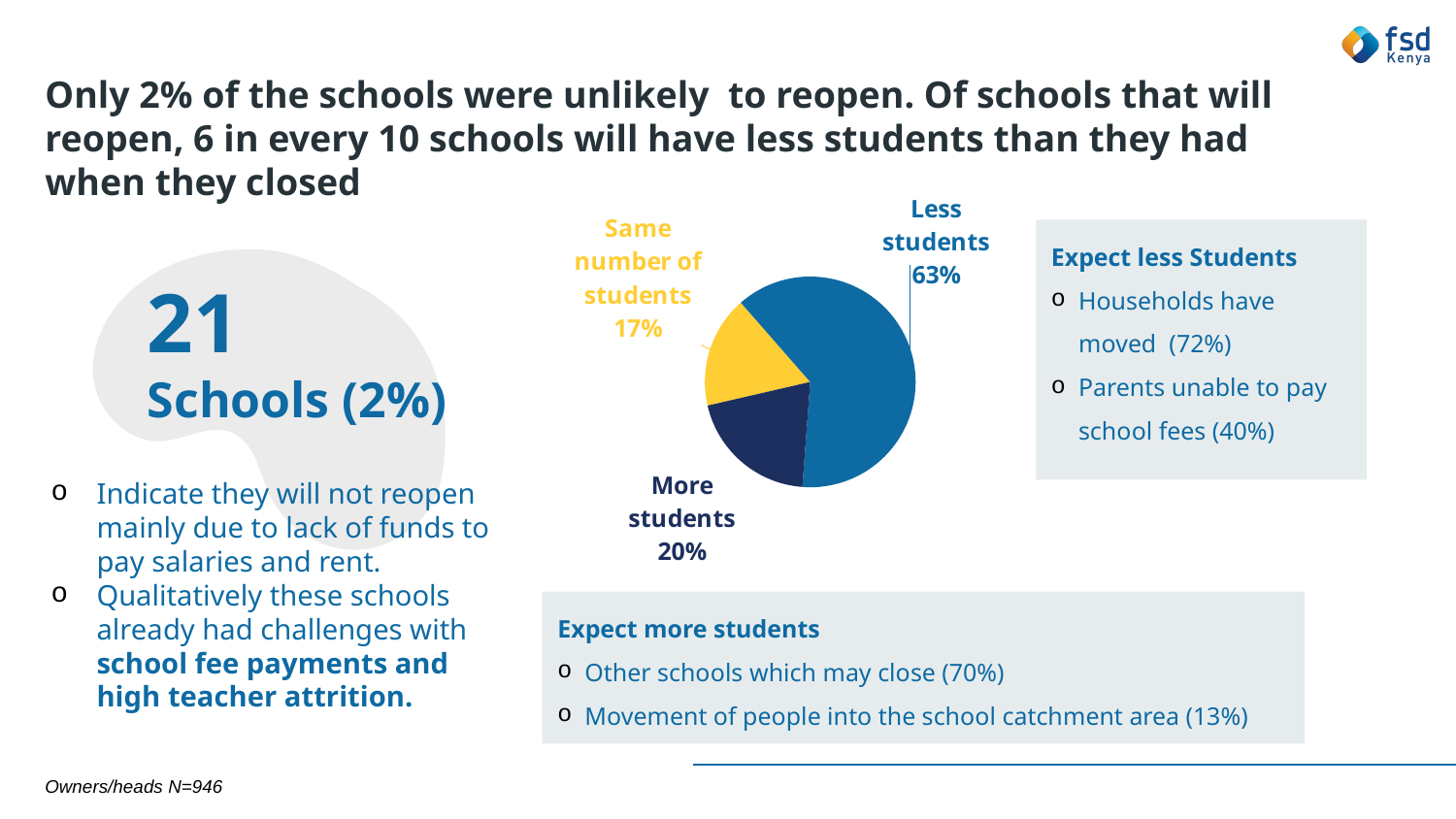
What is the difference in percentage points between schools expecting less students and schools expecting more students? 43 What colour is the slice for 'Same number of students'? Yellow How many categories does the pie chart show? 3 Which category has the smallest slice of the pie chart? Same number of students What colour is the slice for 'Less students'? Blue Which category has the largest slice of the pie chart? Less students Which is larger: the share expecting more students or the share expecting the same number of students? More students What share of schools expect the same number of students? 17% What type of chart is shown on the slide? Pie chart What share of schools expect more students? 20% What share of schools expect less students? 63% What is the combined share of schools expecting more students or the same number of students? 37%